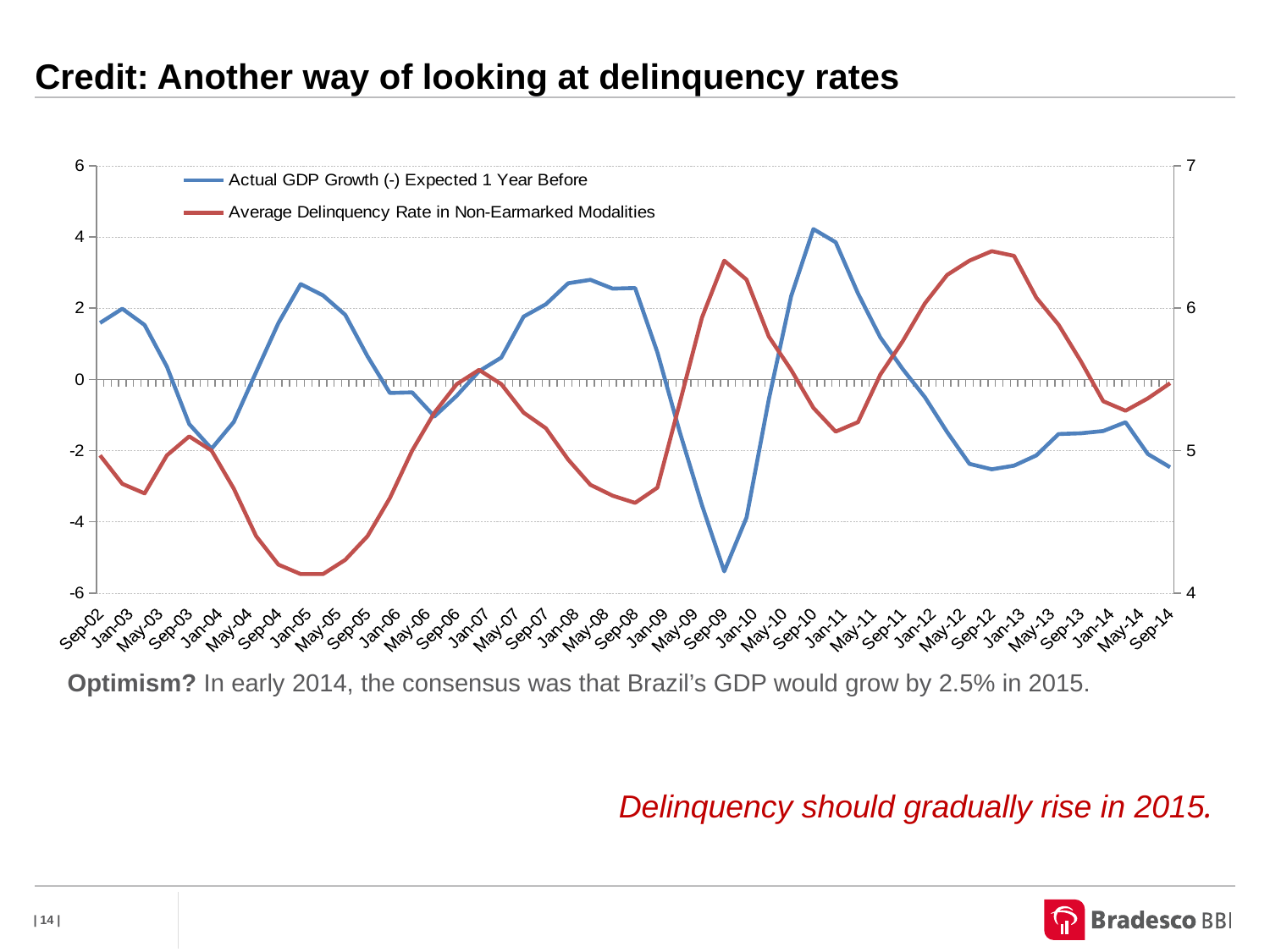
Which is larger for Actual GDP Growth (-) Expected 1 Year Before: the value at Sep-10 or the value at Jan-05? Sep-10 What kind of chart is shown on the slide? Line chart Does the Average Delinquency Rate in Non-Earmarked Modalities rise or fall between Sep-12 and Jan-14? fall Is the value of Actual GDP Growth (-) Expected 1 Year Before at Sep-10 greater or less than 2? greater Which series is drawn in red? Average Delinquency Rate in Non-Earmarked Modalities How many date labels are shown along the x axis? 37 Is the value of Actual GDP Growth (-) Expected 1 Year Before at Sep-09 greater or less than -4? less Is the value of Average Delinquency Rate in Non-Earmarked Modalities at Sep-12 greater or less than 6 on the right-hand axis? greater How many series does the legend list? 2 At which date does Actual GDP Growth (-) Expected 1 Year Before reach its lowest value? Sep-09 What is the highest value shown on the right-hand axis? 7